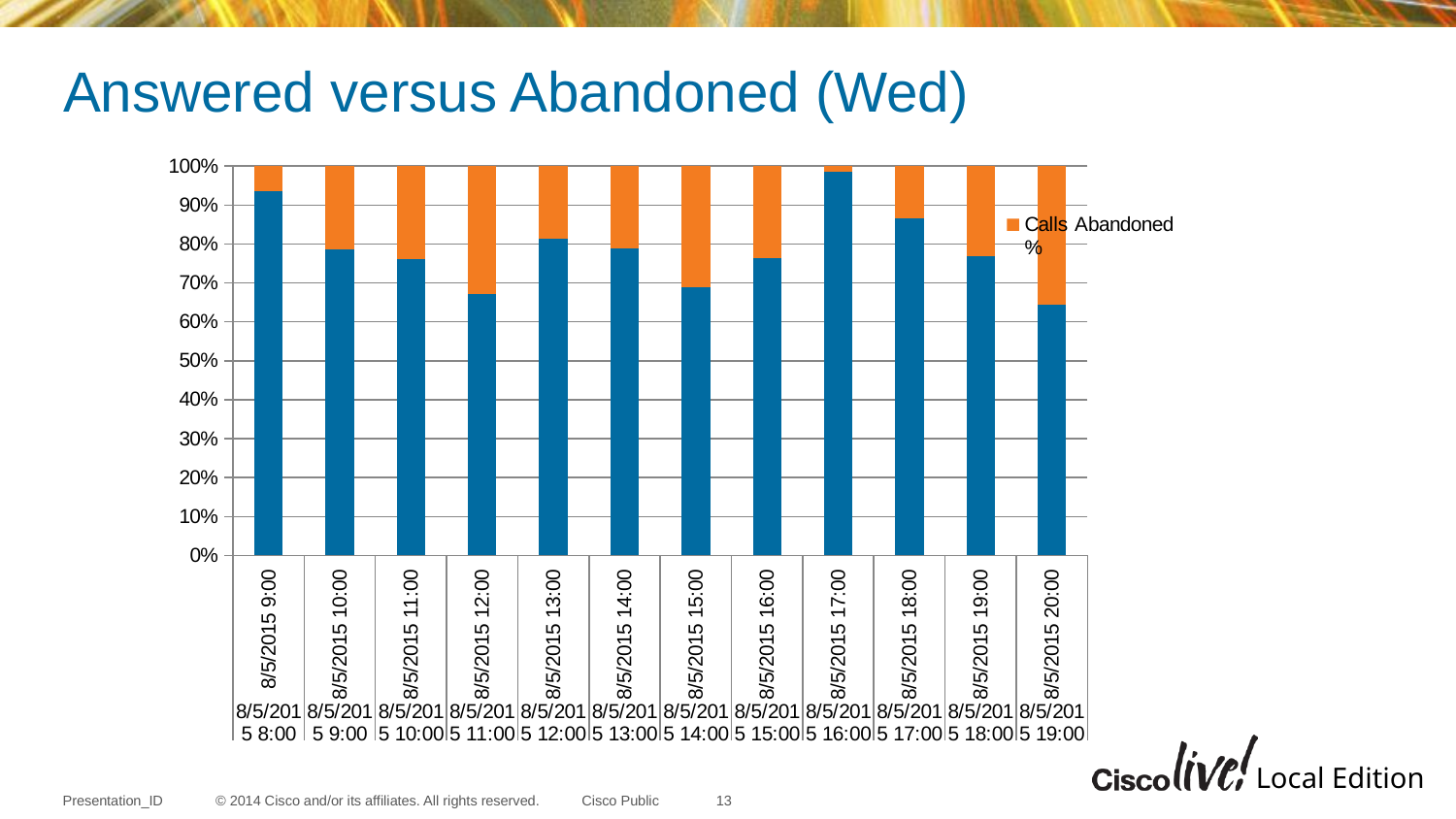
Is the blue (answered) share of the fourth bar (8/5/2015 12:00) greater or less than 70%? less Which bar has the smallest orange (Calls Abandoned %) share? The ninth bar (8/5/2015 17:00) What series name is shown in the chart legend? Calls Abandoned % What is the title of the chart? Answered versus Abandoned (Wed) Is the blue (answered) share of the first bar greater or less than 90%? greater Is the blue (answered) share of the tenth bar (8/5/2015 18:00) greater or less than 80%? greater Which bar has the largest blue (answered) share: the first bar or the last bar? The first bar How many bars (time slots) are plotted in the chart? 12 What value does each stacked bar total on the y axis? 100% Which bar has the largest orange (Calls Abandoned %) share? The last bar (8/5/2015 20:00) What kind of chart is shown on the slide? Stacked bar chart